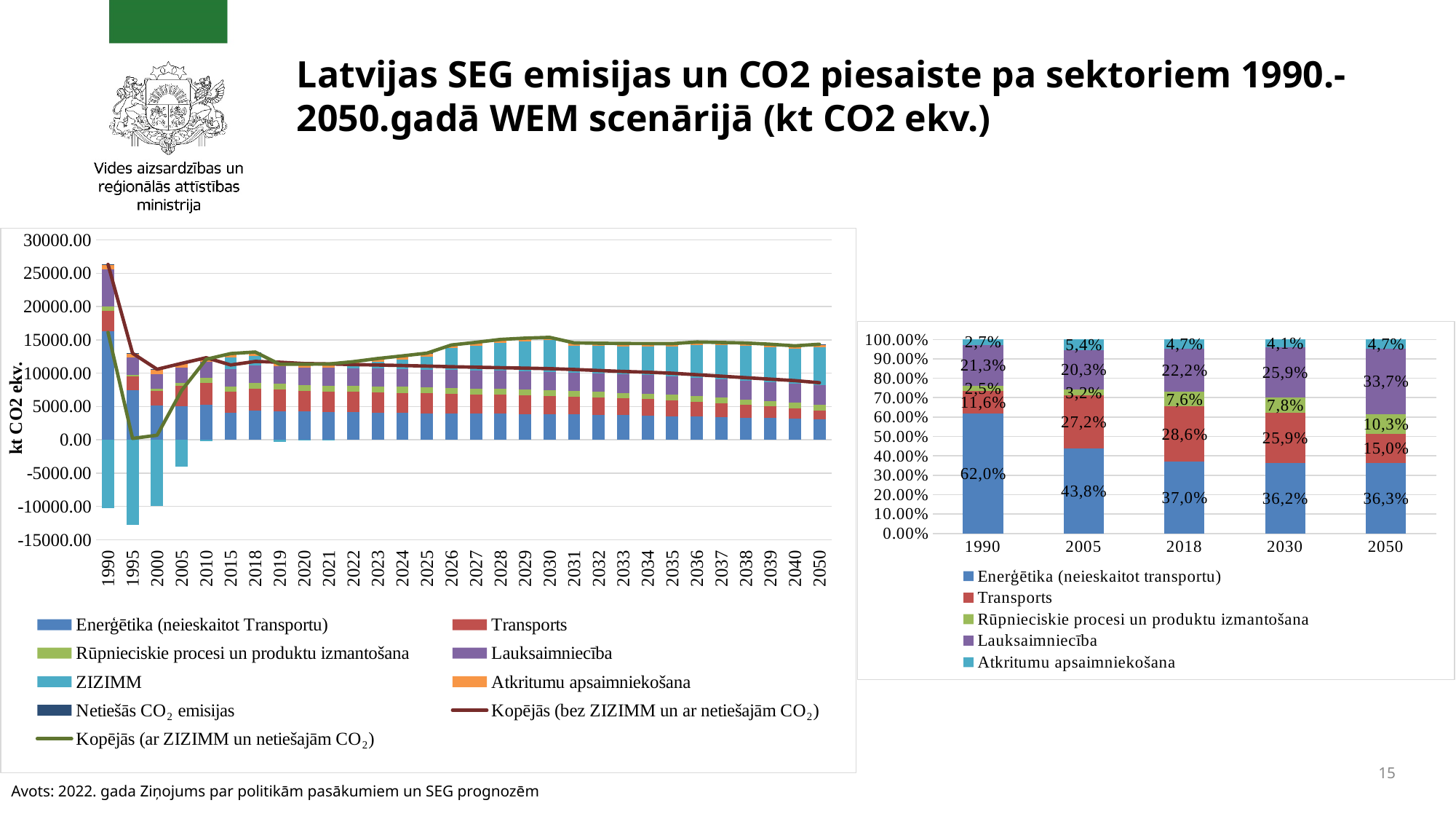
In the right chart, what share does Enerģētika (neieskaitot transportu) have in 1990? 62,0% In the left chart, how many entries does the legend list? 9 In the right chart, how many years are shown on the x axis? 5 In the right chart, which year has the lowest share for Rūpnieciskie procesi un produktu izmantošana? 1990 In the right chart, how many series does the legend list? 5 In the right chart, which is larger in 2050: the share of Transports or the share of Lauksaimniecība? Lauksaimniecība In the left chart, is the ZIZIMM value for 1995 greater or less than -10000.00? less In the right chart, what share does Transports have in 2018? 28,6% In the right chart, what is the difference between the Enerģētika share in 1990 and in 2005? 18,2% In the right chart, which year has the highest share for Transports? 2018 In the right chart, what share does Lauksaimniecība have in 2050? 33,7% In the left chart, does the Kopējās (bez ZIZIMM un ar netiešajām CO2) line rise or fall from 2030 to 2050? fall